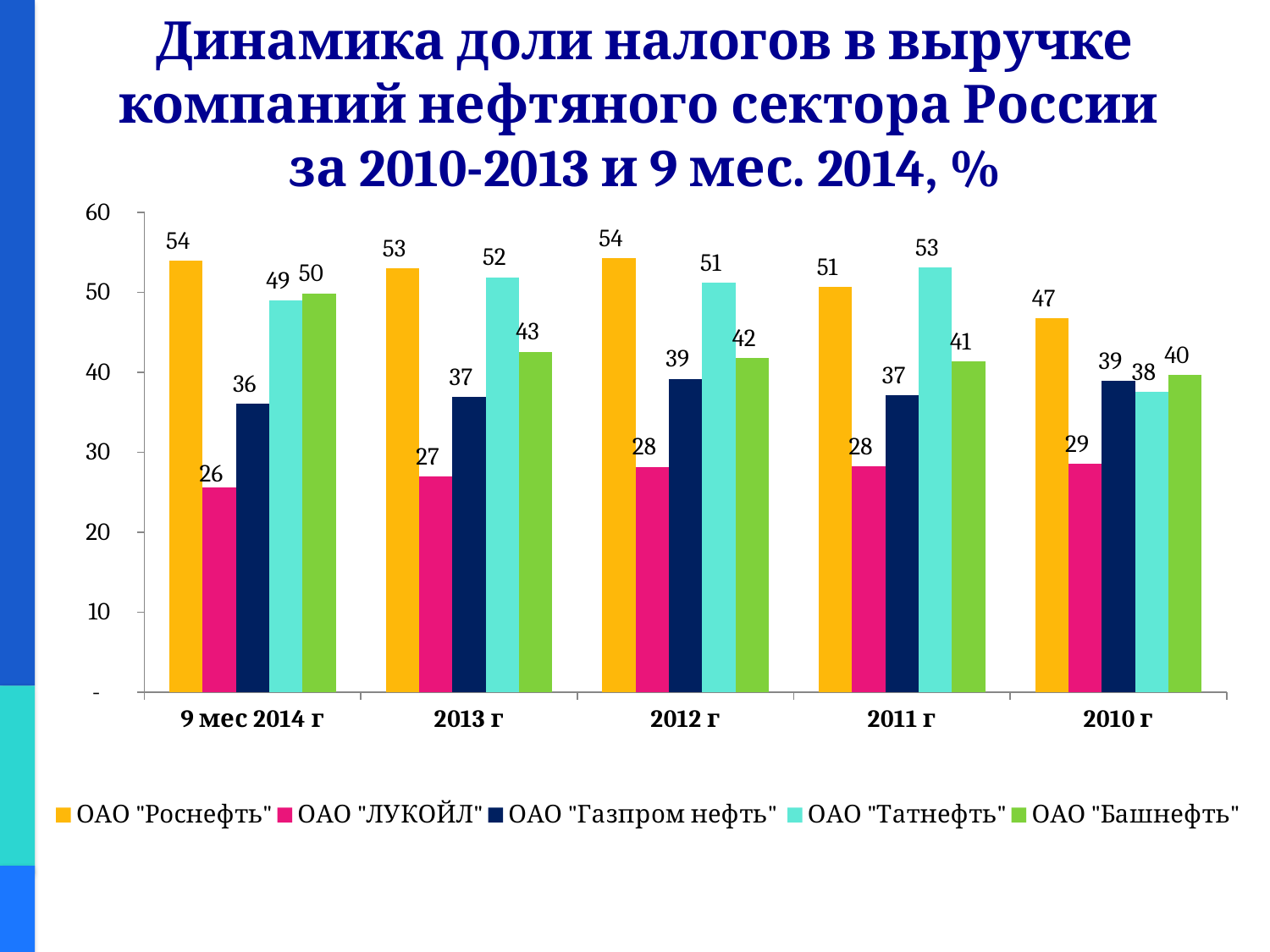
Which company has the highest value in 2011 г? ОАО "Татнефть" How many periods are shown on the x axis? 5 Which is larger in 2010 г: ОАО "Газпром нефть" or ОАО "Татнефть"? ОАО "Газпром нефть" What is the value for ОАО "Татнефть" in 2011 г? 53 Which colour represents ОАО "Башнефть" in the chart? Green What is the value for ОАО "Роснефть" in 2010 г? 47 What is the difference between ОАО "Роснефть" and ОАО "ЛУКОЙЛ" in 2013 г? 26 Which company has the lowest value in 2012 г? ОАО "ЛУКОЙЛ" What kind of chart is shown on the slide? Bar chart What is the value for ОАО "ЛУКОЙЛ" in 9 мес 2014 г? 26 What is the value for ОАО "Башнефть" in 2013 г? 43 How many series does the legend list? 5